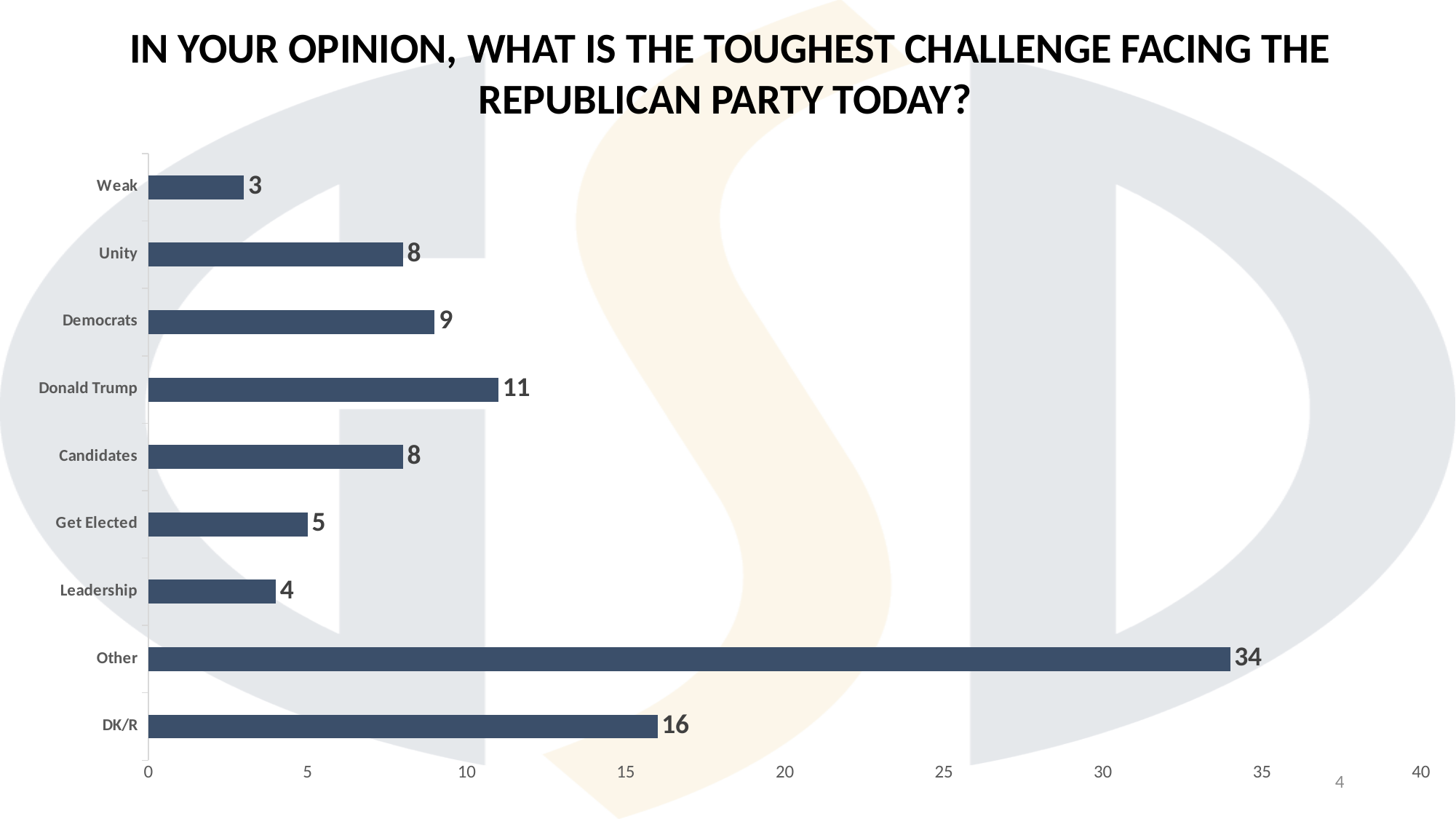
What kind of chart is shown on the slide? bar chart How many categories are shown in the chart? 9 Which category has the lowest value? Weak Which category has the highest value? Other Which is larger, the value for Unity or the value for Donald Trump? Donald Trump What is the difference between the values for Other and DK/R? 18 What is the value for Get Elected? 5 What is the difference between the values for Democrats and Leadership? 5 What is the value for Donald Trump? 11 What is the title of the chart? In your opinion, what is the toughest challenge facing the Republican Party today? Is the value for Other greater or less than 30? greater What is the value for DK/R? 16